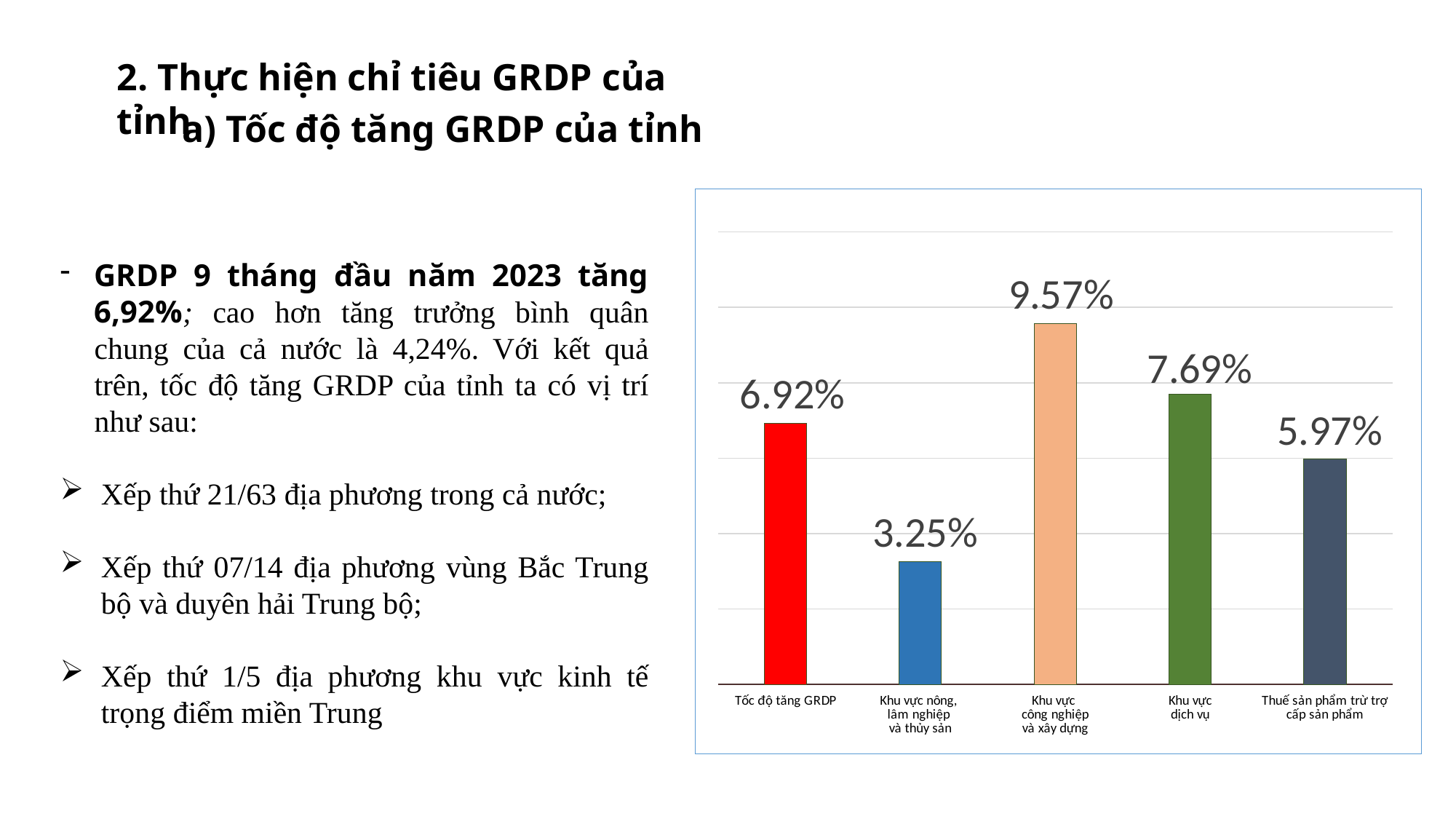
What is the difference between the values for Khu vực công nghiệp và xây dựng and Khu vực nông, lâm nghiệp và thủy sản? 6.32% What is the difference between the values for Khu vực dịch vụ and Thuế sản phẩm trừ trợ cấp sản phẩm? 1.72% How many bars are plotted in the chart? 5 Which is larger, the value for Khu vực dịch vụ or the value for Tốc độ tăng GRDP? Khu vực dịch vụ What is the value shown for Tốc độ tăng GRDP? 6.92% What is the value shown for Khu vực công nghiệp và xây dựng? 9.57% Which category has the highest value in the chart? Khu vực công nghiệp và xây dựng What is the value shown for Thuế sản phẩm trừ trợ cấp sản phẩm? 5.97% What colour is the bar for Tốc độ tăng GRDP? Red Which category has the lowest value in the chart? Khu vực nông, lâm nghiệp và thủy sản What is the value shown for Khu vực nông, lâm nghiệp và thủy sản? 3.25% What kind of chart is shown on the slide? Bar chart